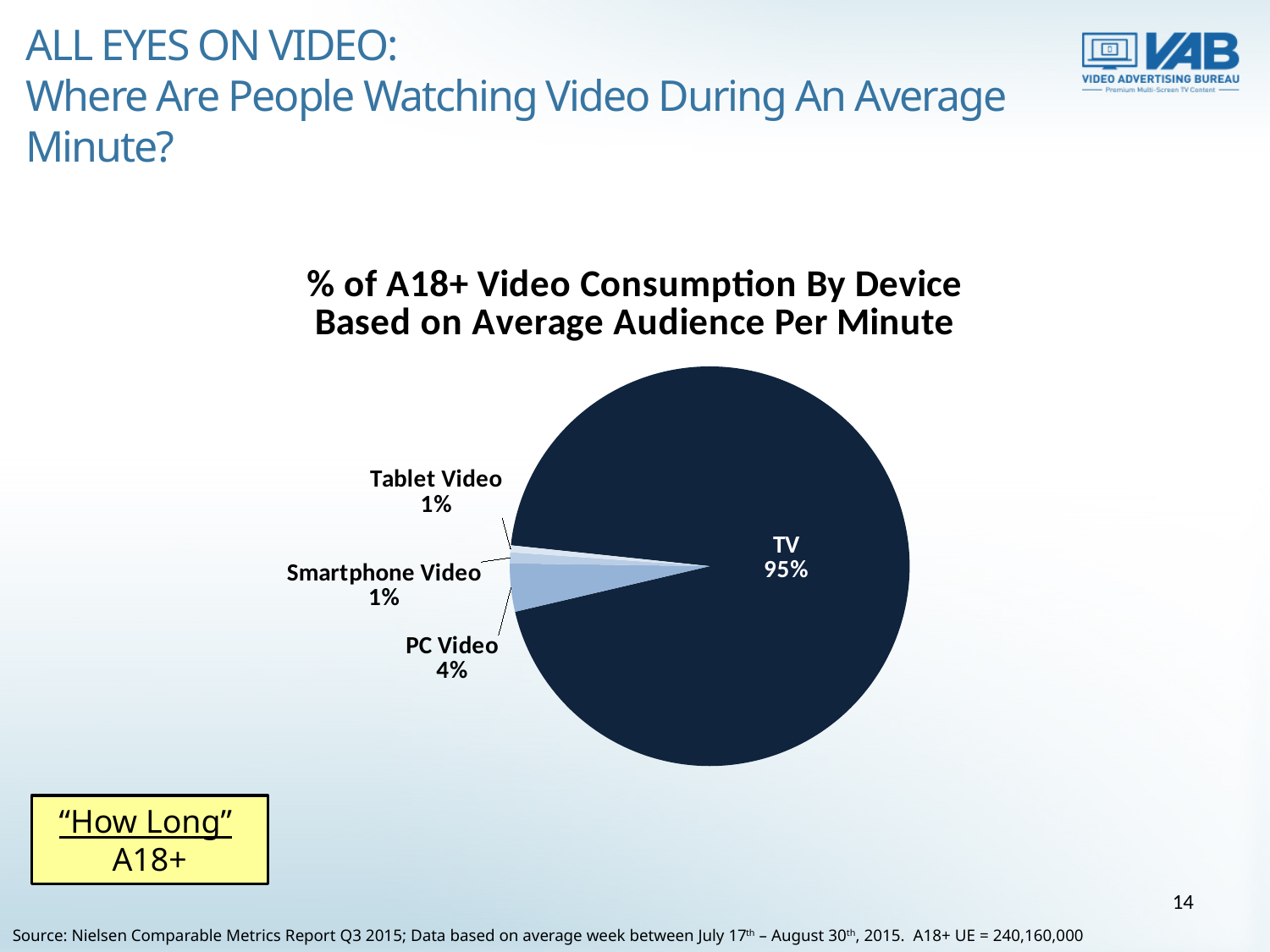
What is the title of the chart? % of A18+ Video Consumption By Device Based on Average Audience Per Minute What is the value for PC Video? 4% Which device has the largest share of video consumption? TV What is the difference between the PC Video share and the Smartphone Video share? 3% What is the value for Smartphone Video? 1% What type of chart is shown on the slide? pie chart What is the value for Tablet Video? 1% How many slices does the pie chart have? 4 What is the difference between the TV share and the PC Video share? 91% What is the combined share of PC Video, Smartphone Video and Tablet Video? 6% Which is larger, the share for PC Video or the share for Tablet Video? PC Video What share of A18+ video consumption does TV account for? 95%